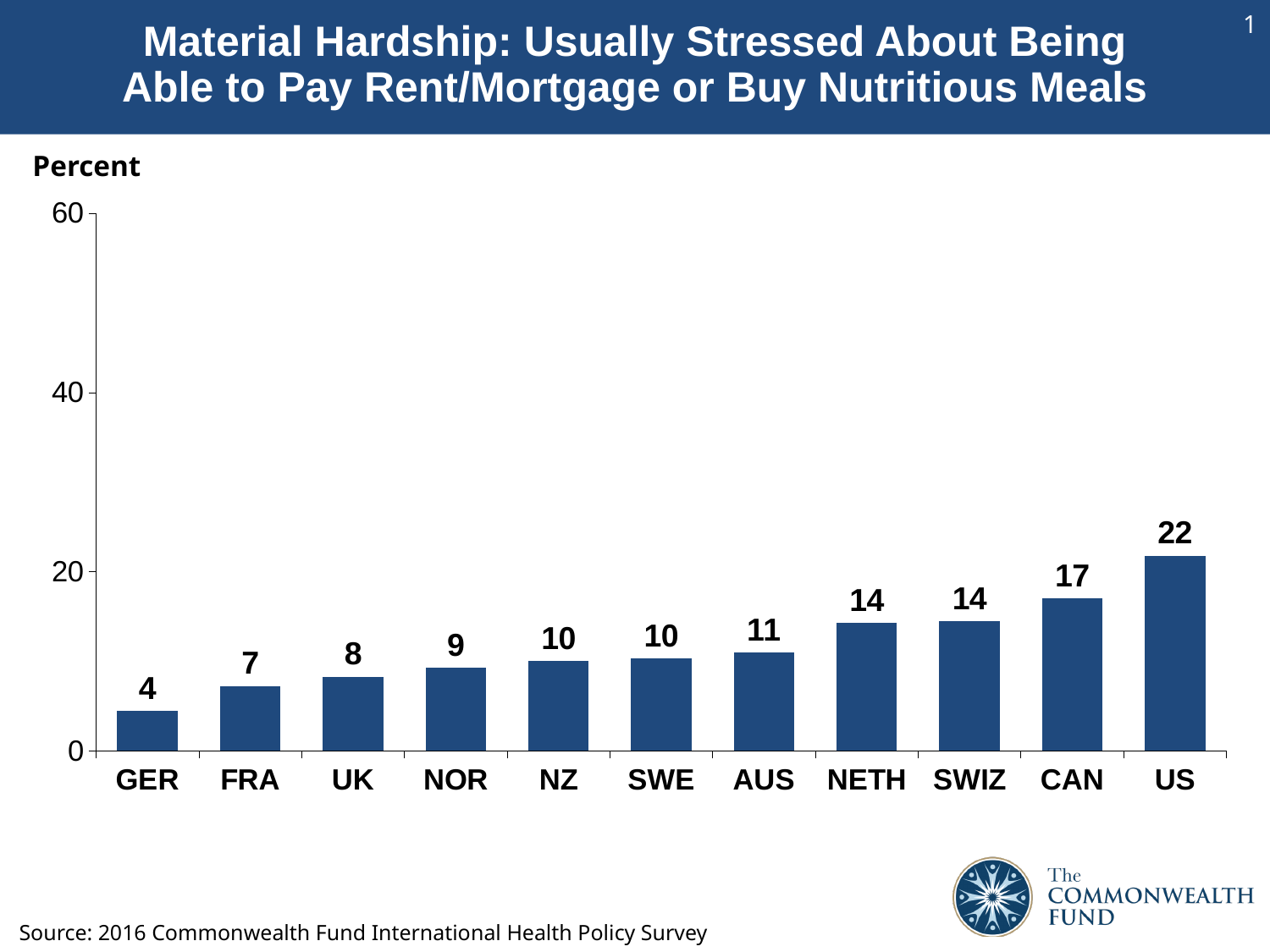
Which country has the highest value? US What is the value for NETH? 14 What kind of chart is shown on the slide? bar chart Which country has the lowest value? GER What is the value for the US? 22 Is the value for the US greater or less than 20? greater How many countries are shown on the chart? 11 What is the difference between the values for the US and CAN? 5 Which is larger, the value for SWIZ or the value for UK? SWIZ What is the value for GER? 4 What is the difference between the values for AUS and FRA? 4 Do the values rise or fall from left to right along the x axis? rise